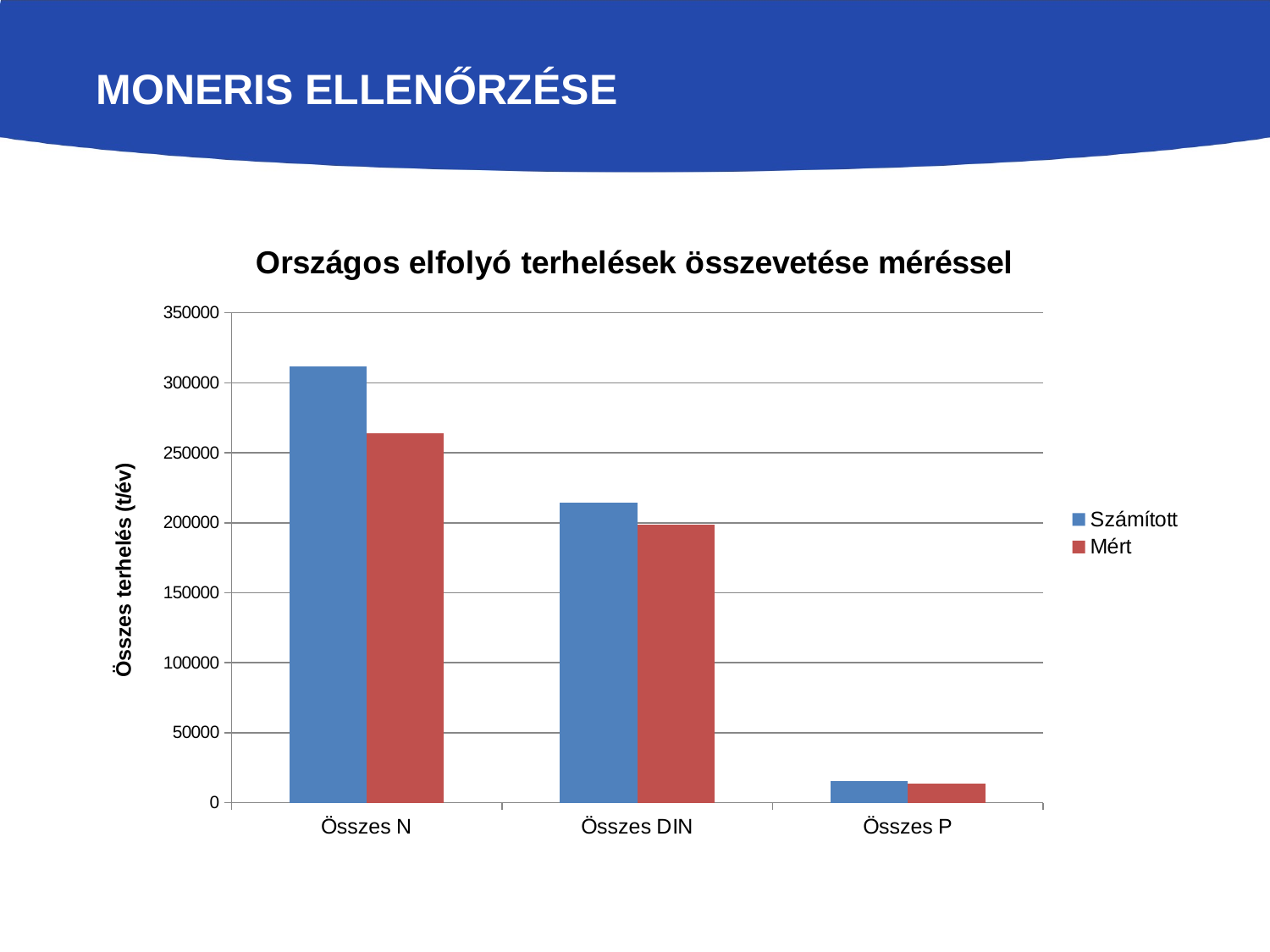
Is the Mért value for Összes N greater or less than 250000? greater How many categories are shown on the x axis? 3 What type of chart is shown on the slide? bar chart Which category has the lowest Mért value? Összes P What is the label of the y axis? Összes terhelés (t/év) What is the title of the chart? Országos elfolyó terhelések összevetése méréssel How many series does the legend list? 2 Is the Számított value for Összes DIN greater or less than 200000? greater Is the Mért value for Összes P greater or less than 50000? less Which category has the highest Számított value? Összes N For Összes N, which is larger: the Számított value or the Mért value? Számított